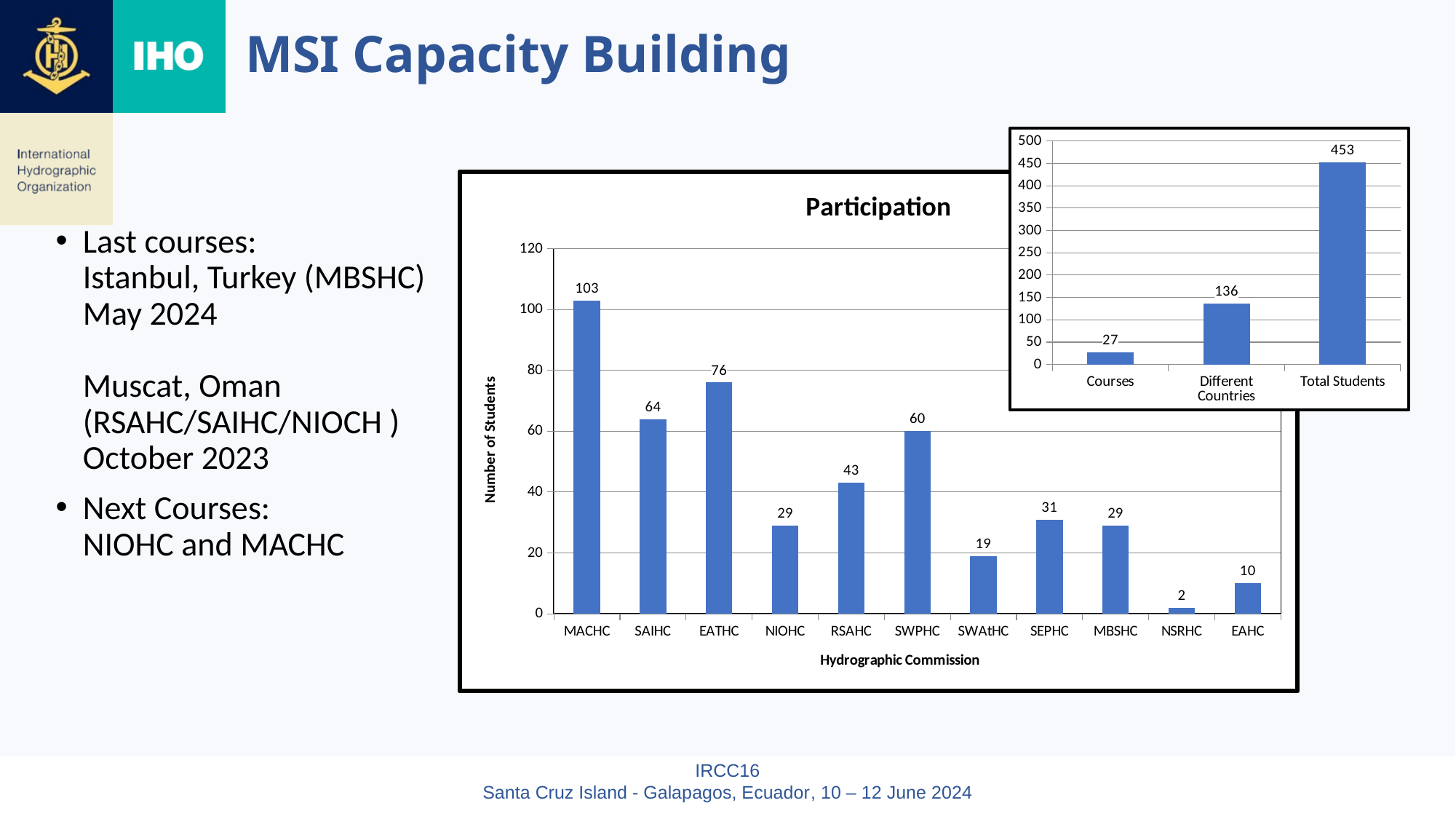
What is the y-axis label of the Participation chart? Number of Students In the chart at the top right, what is the value for Total Students? 453 In the Participation chart, which has more students, RSAHC or SEPHC? RSAHC In the Participation chart, which hydrographic commission has the highest number of students? MACHC In the chart at the top right, what is the value for Different Countries? 136 In the chart at the top right, what is the difference between Total Students and Courses? 426 In the Participation chart, what is the difference in number of students between EATHC and SAIHC? 12 In the Participation chart, which hydrographic commission has the lowest number of students? NSRHC In the Participation chart, how many hydrographic commissions are shown on the x axis? 11 What kind of chart is the Participation chart? Bar chart In the Participation chart, what is the number of students for SWPHC? 60 In the Participation chart, what is the number of students for MACHC? 103